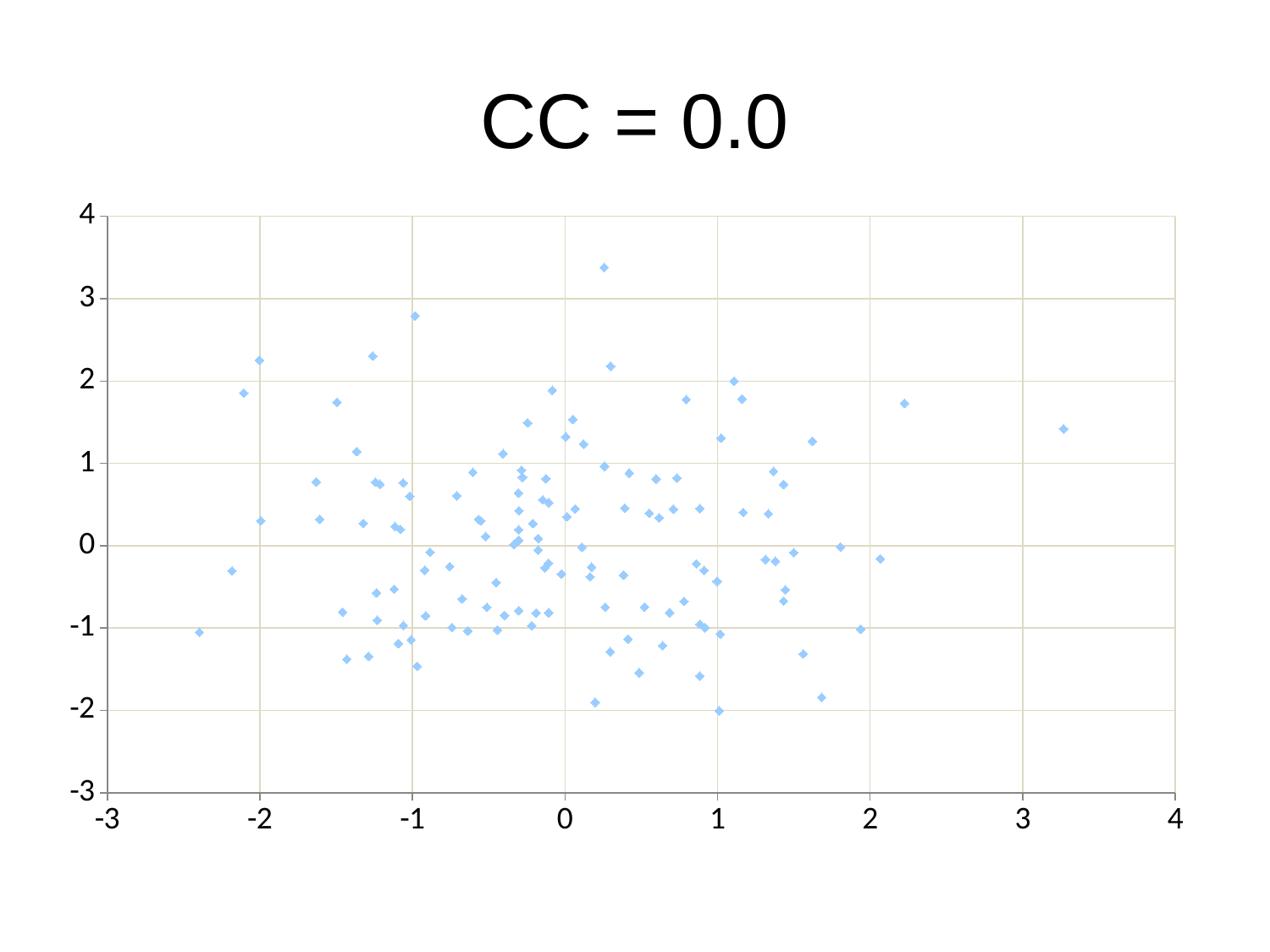
What is the minimum value shown on the y axis? -3 What is the title of the chart? CC = 0.0 Do the y values show a clear rising or falling trend as x increases? no clear trend Is the y value of the highest point on the chart greater or less than 3? greater Is the y value of the lowest point on the chart greater or less than -1? less Is the x value of the leftmost point on the chart greater or less than -2? less What is the maximum value shown on the x axis? 4 Does the chart have a legend? no What kind of chart is shown on the slide? scatter plot